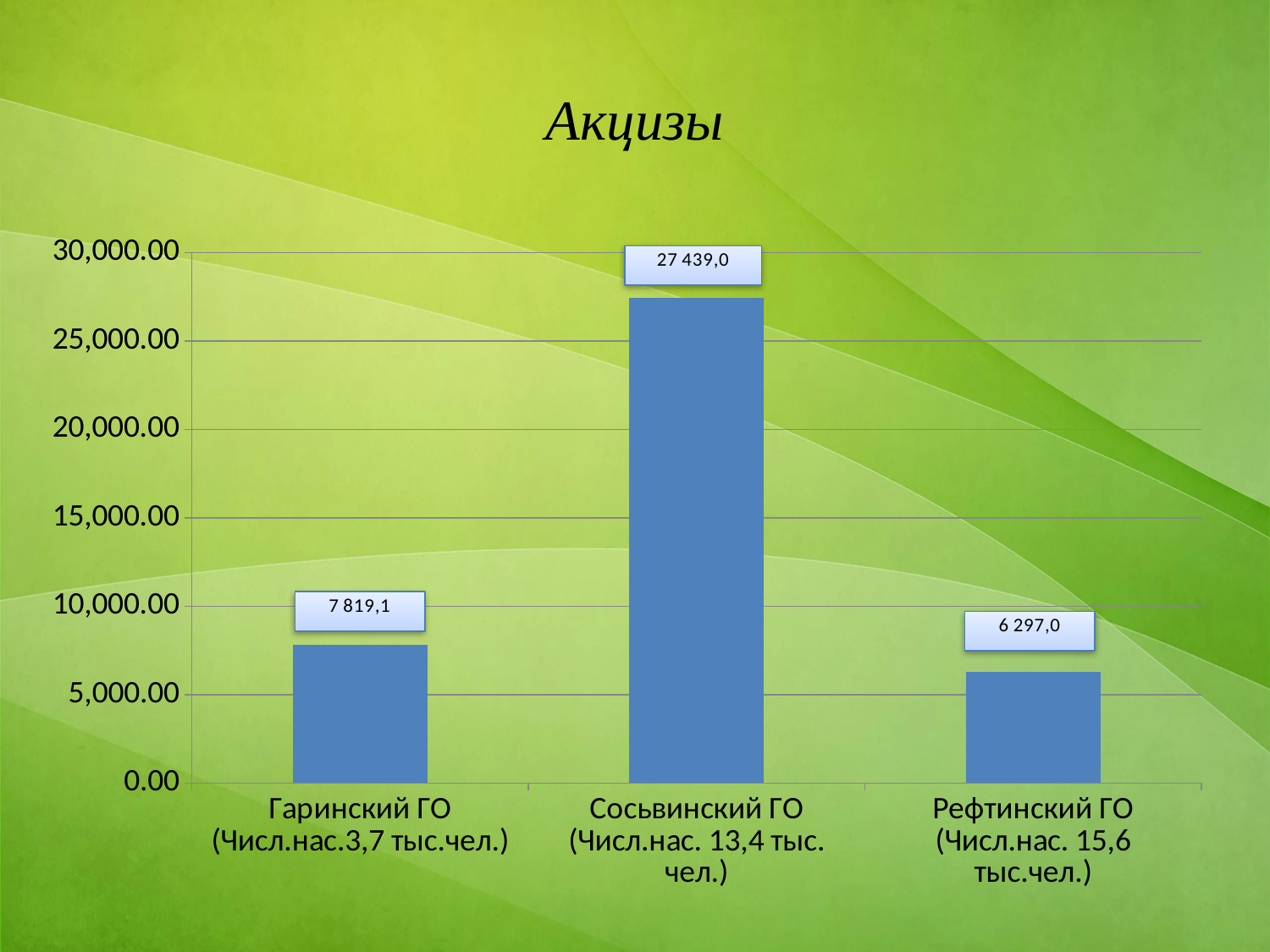
Which category has the lowest value? Рефтинский ГО What kind of chart is shown on the slide? bar chart What is the value for Гаринский ГО? 7 819,1 Is the value for Сосьвинский ГО greater or less than 25,000.00? greater How many categories are shown on the chart? 3 What is the value for Сосьвинский ГО? 27 439,0 What is the value for Рефтинский ГО? 6 297,0 What is the title of the chart? Акцизы What is the difference between the values for Гаринский ГО and Рефтинский ГО? 1 522,1 Which category has the highest value? Сосьвинский ГО Which is larger, the value for Гаринский ГО or the value for Рефтинский ГО? Гаринский ГО What is the difference between the values for Сосьвинский ГО and Гаринский ГО? 19 619,9